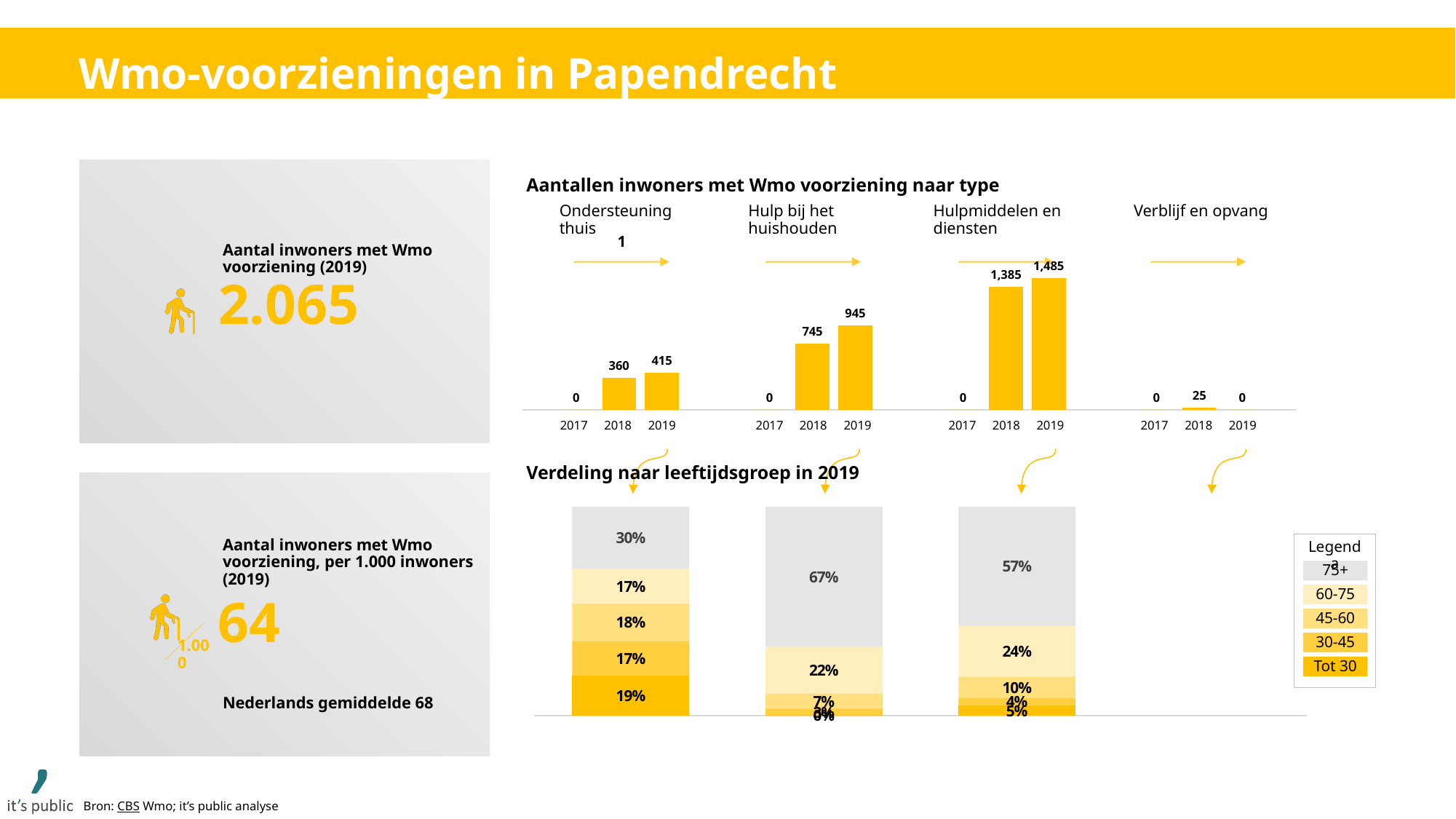
In the chart 'Aantallen inwoners met Wmo voorziening naar type', what is the difference between the 2019 and 2018 values for Ondersteuning thuis? 55 In the chart 'Verdeling naar leeftijdsgroep in 2019', what share of Hulpmiddelen en diensten is the 75+ age group? 57% In the chart 'Aantallen inwoners met Wmo voorziening naar type', which type has the highest value in 2019? Hulpmiddelen en diensten How many age groups does the legend of the chart 'Verdeling naar leeftijdsgroep in 2019' list? 5 What kind of chart is 'Aantallen inwoners met Wmo voorziening naar type'? bar chart In the chart 'Verdeling naar leeftijdsgroep in 2019', what share of Ondersteuning thuis is the 75+ age group? 30% In the chart 'Aantallen inwoners met Wmo voorziening naar type', what is the value for Hulpmiddelen en diensten in 2018? 1,385 In the chart 'Aantallen inwoners met Wmo voorziening naar type', what is the value for Hulp bij het huishouden in 2019? 945 In the chart 'Aantallen inwoners met Wmo voorziening naar type', what is the difference between the 2019 and 2018 values for Hulpmiddelen en diensten? 100 In the chart 'Aantallen inwoners met Wmo voorziening naar type', what is the value for Verblijf en opvang in 2018? 25 In the chart 'Aantallen inwoners met Wmo voorziening naar type', which is larger in 2019: Hulp bij het huishouden or Ondersteuning thuis? Hulp bij het huishouden In the chart 'Aantallen inwoners met Wmo voorziening naar type', do the values for Hulp bij het huishouden rise or fall from 2017 to 2019? rise